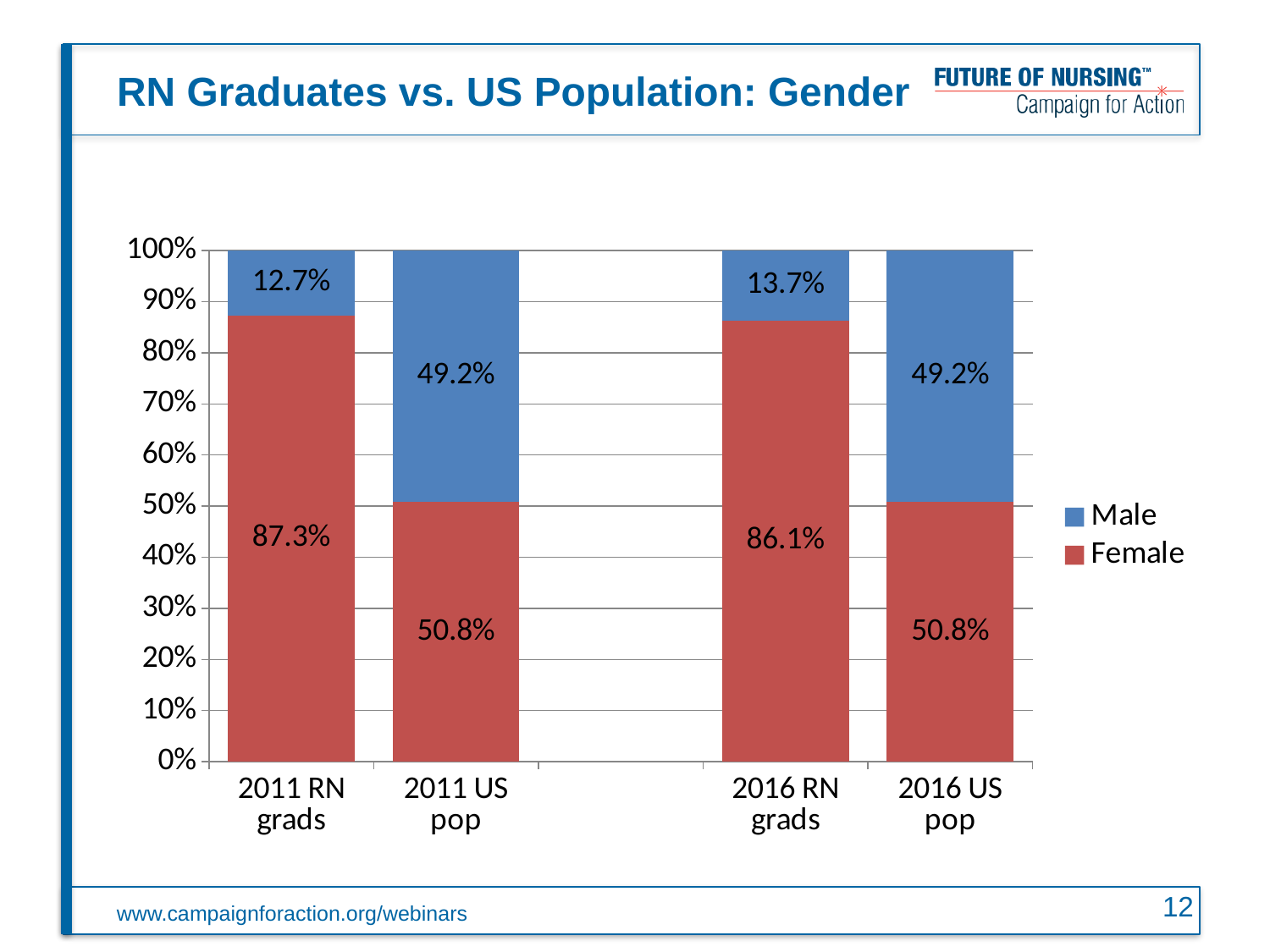
Which colour represents Female in the chart? Red What is the Male value for 2016 RN grads? 13.7% Which category has the lowest Male value? 2011 RN grads Which category has the highest Female value? 2011 RN grads What is the Female value for 2011 RN grads? 87.3% What is the Male value for 2011 US pop? 49.2% What kind of chart is shown on the slide? Stacked bar chart How many series does the legend list? 2 How many categories are shown on the x axis? 4 What is the difference between the Female value for 2011 RN grads and the Female value for 2016 RN grads? 1.2% Which is larger: the Male value for 2016 RN grads or the Male value for 2011 RN grads? 2016 RN grads What is the Female value for 2016 US pop? 50.8%